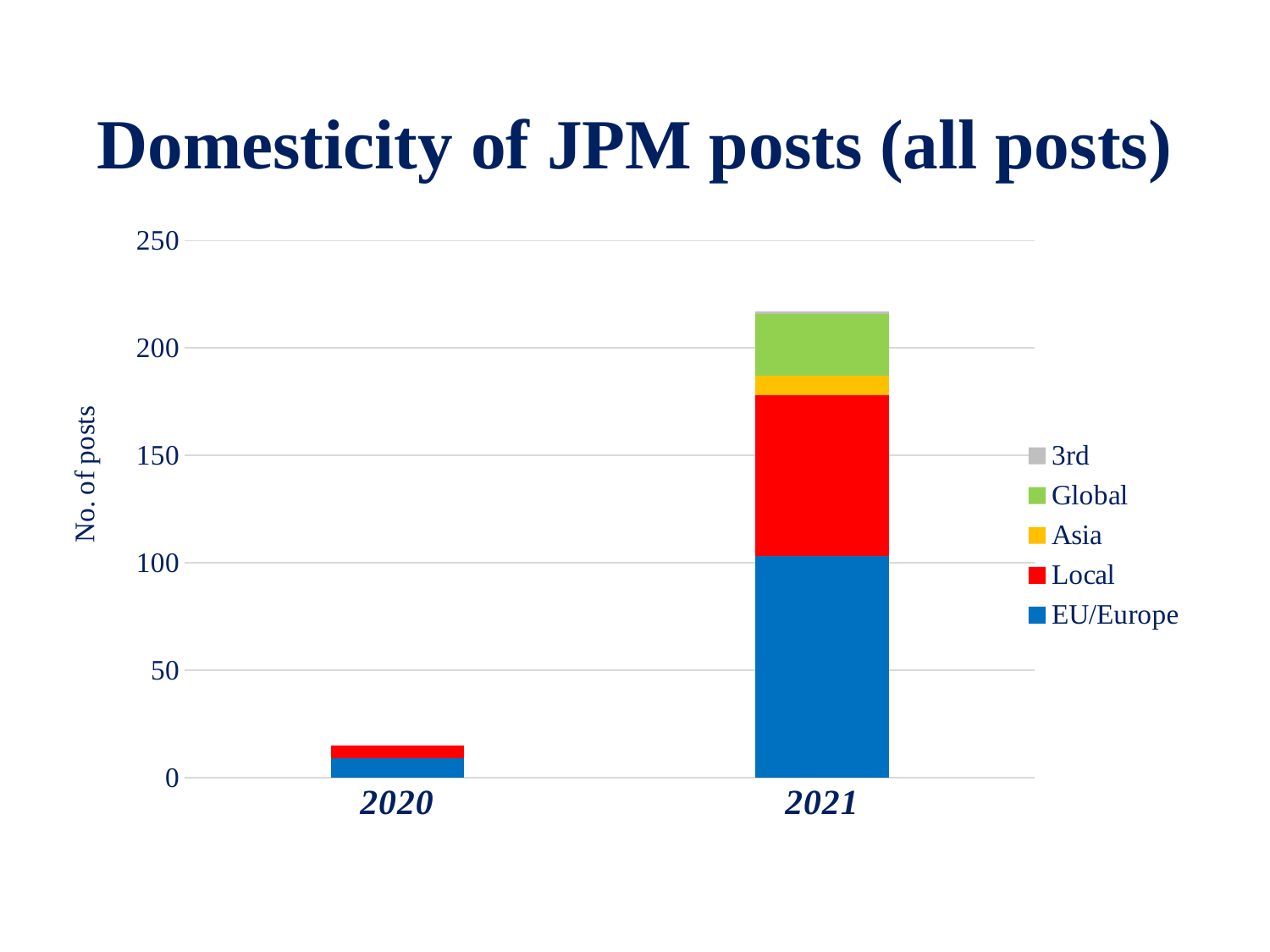
Is the EU/Europe value for 2021 greater or less than 50? greater How many categories are shown on the x axis? 2 Is the total number of posts for 2020 greater or less than 50? less Which is larger, the total for 2020 or the total for 2021? 2021 What type of chart is shown on the slide? stacked bar chart Which year has the higher total number of posts? 2021 What is the label of the y axis? No. of posts Do the total number of posts rise or fall from 2020 to 2021? rise How many series does the legend list? 5 Is the total number of posts for 2021 greater or less than 200? greater Which year has the lower total number of posts? 2020 What is the title of the chart? Domesticity of JPM posts (all posts)